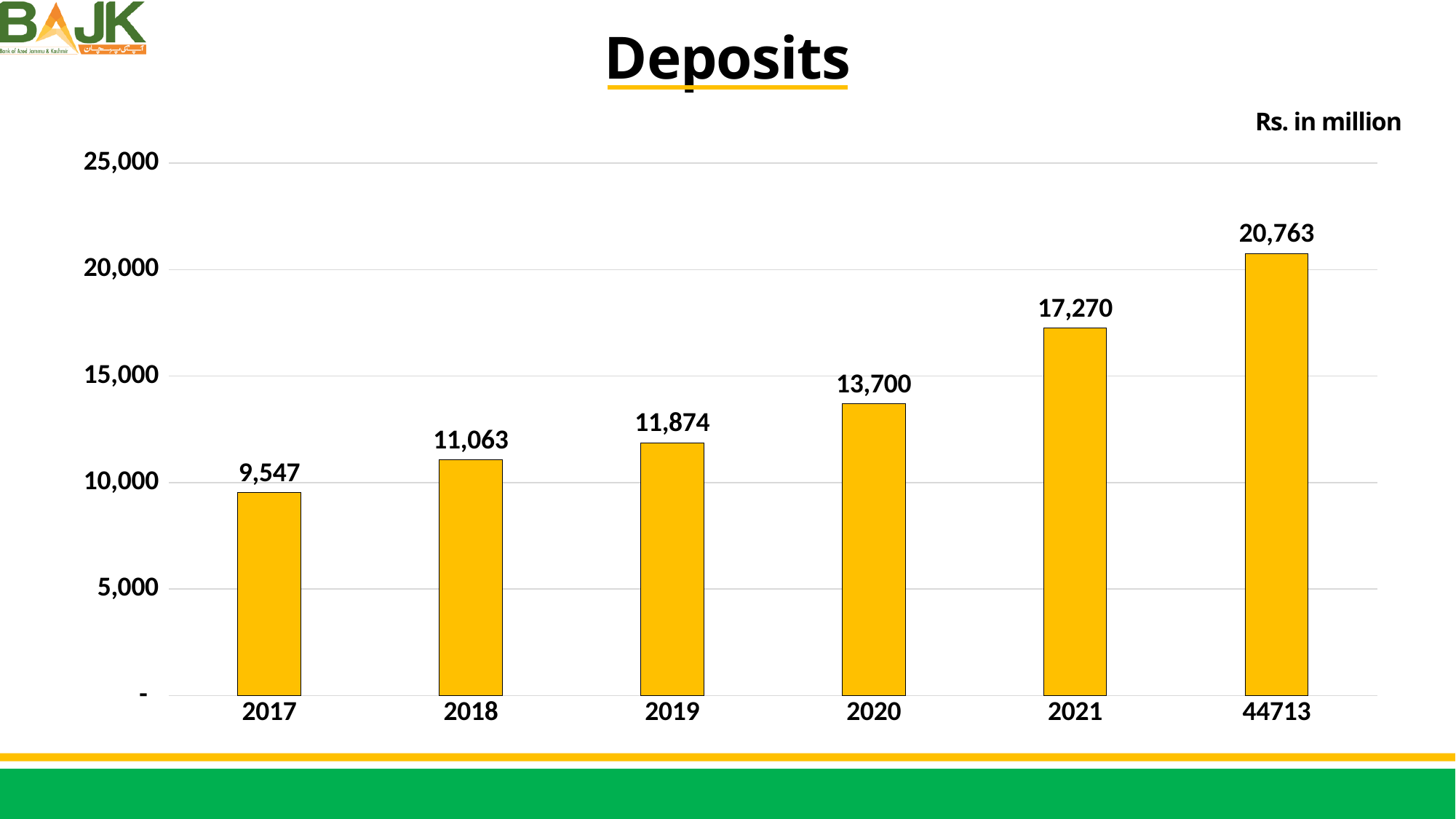
Which category has the highest deposits value? 44713 How many bars are shown in the chart? 6 Which is larger, the deposits value for 2018 or for 2019? 2019 Which category has the lowest deposits value? 2017 What kind of chart is shown on the slide? Bar chart What is the difference between the deposits values for 2019 and 2018? 811 What is the deposits value for 2017? 9,547 What is the deposits value for 2020? 13,700 Do the deposits values rise or fall from left to right along the x axis? Rise What is the deposits value for 2021? 17,270 What is the value of the bar labelled 44713? 20,763 What is the difference between the deposits values for 2021 and 2020? 3,570